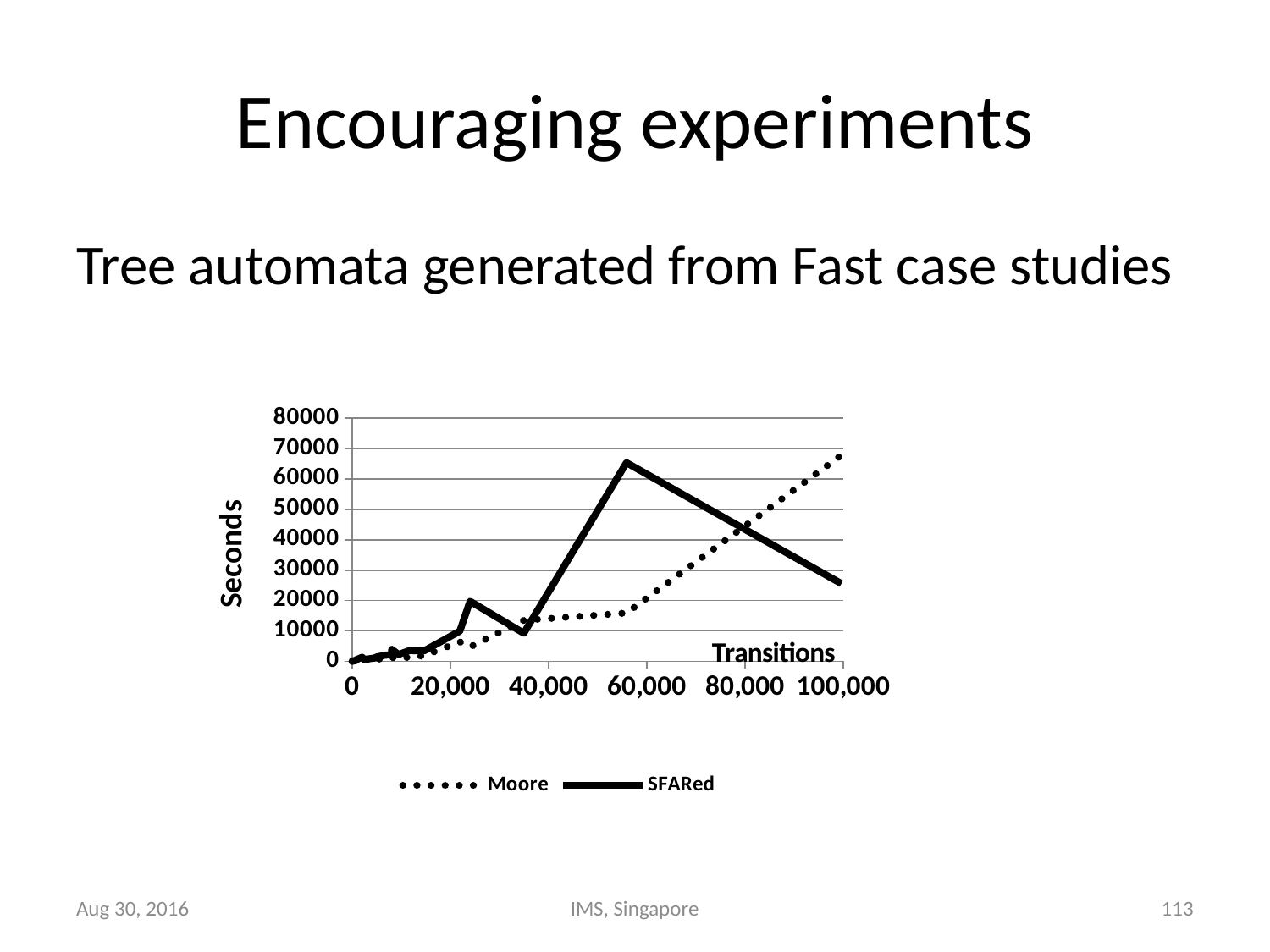
Is the value for SFARed at its peak (around 56,000 transitions) greater or less than 60000 seconds? greater What kind of chart is shown on the slide? line chart Is the value for Moore at 100,000 transitions greater or less than 60000 seconds? greater At 60,000 transitions, which series has the higher value, Moore or SFARed? SFARed Does the SFARed series rise or fall between about 56,000 and 100,000 transitions? fall How many series does the legend list? 2 Is the value for SFARed at 100,000 transitions greater or less than 30000 seconds? less Does the Moore series generally rise or fall as transitions increase? rise What are the two series named in the legend? Moore and SFARed What is the label of the vertical axis? Seconds At 100,000 transitions, which series has the higher value, Moore or SFARed? Moore